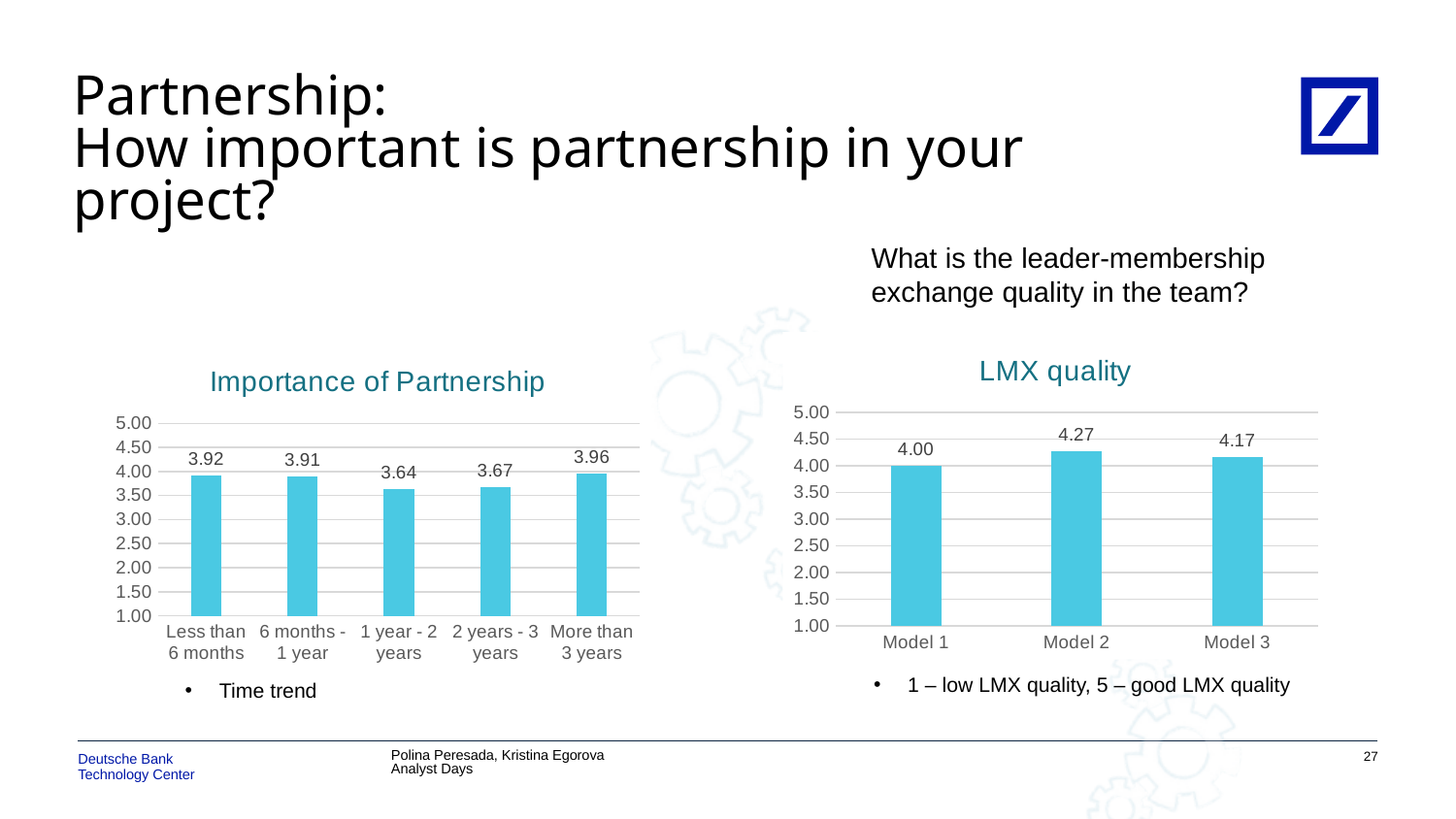
In the 'Importance of Partnership' chart, which category has the lowest value? 1 year - 2 years In the 'Importance of Partnership' chart, what is the value for 'Less than 6 months'? 3.92 In the 'LMX quality' chart, what is the difference between the values for Model 2 and Model 3? 0.10 In the 'Importance of Partnership' chart, what is the value for '2 years - 3 years'? 3.67 In the 'LMX quality' chart, what is the value for Model 2? 4.27 In the 'LMX quality' chart, which model has the highest value? Model 2 In the 'Importance of Partnership' chart, which category has the highest value? More than 3 years What type of chart is the 'LMX quality' chart? Bar chart In the 'LMX quality' chart, which model has the lowest value? Model 1 In the 'Importance of Partnership' chart, what is the difference between the values for 'More than 3 years' and '1 year - 2 years'? 0.32 In the 'Importance of Partnership' chart, how many categories are shown on the x axis? 5 In the 'LMX quality' chart, how many models are shown? 3